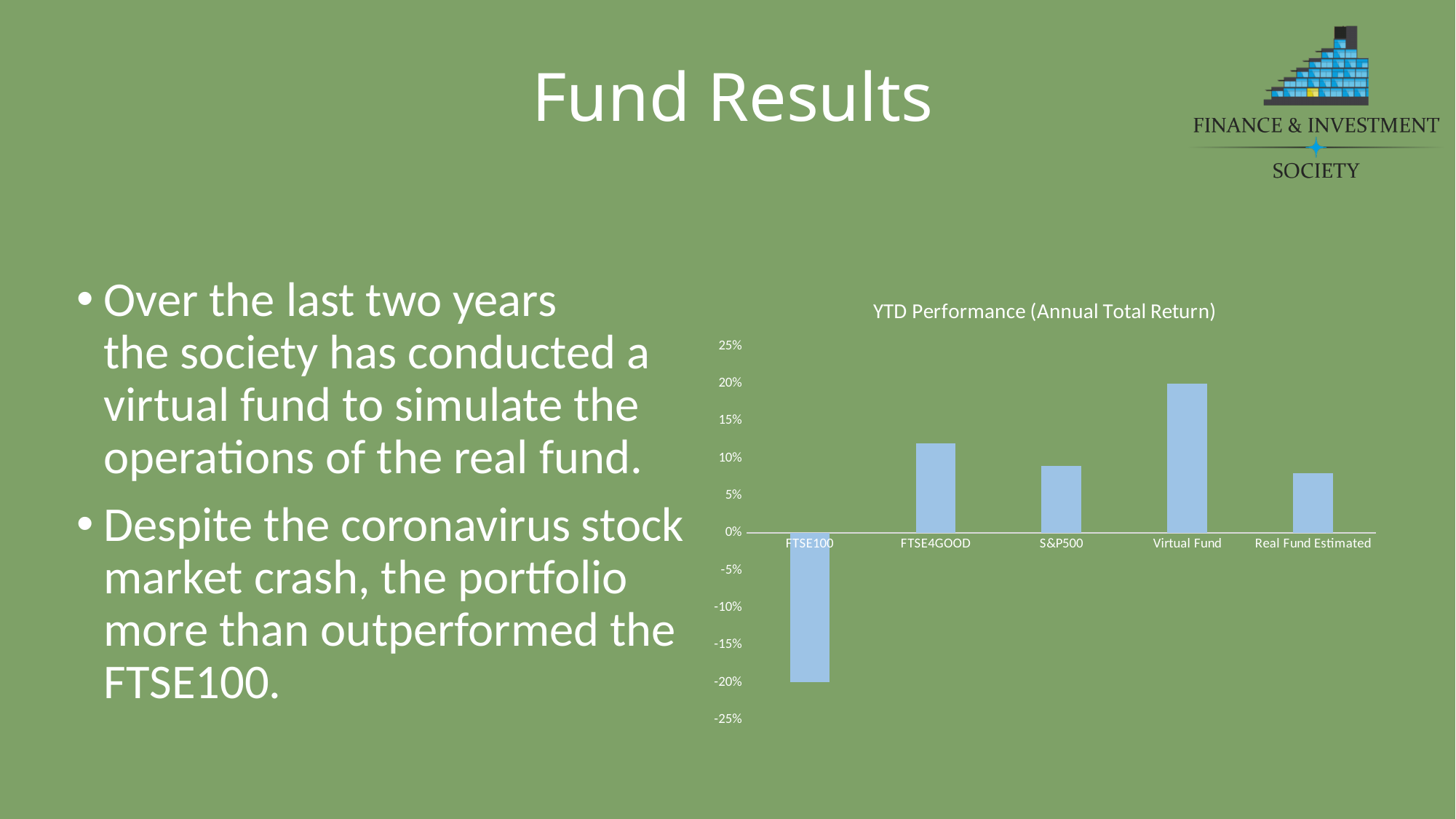
Is the value for S&P500 greater or less than 10%? less Which category has the highest YTD performance? Virtual Fund How many categories are plotted in the chart? 5 Is the value for FTSE4GOOD greater or less than 10%? greater How many categories in the chart have a negative value? 1 Which category has the lowest YTD performance? FTSE100 What is the title of the chart? YTD Performance (Annual Total Return) Which is larger, the value for FTSE4GOOD or the value for S&P500? FTSE4GOOD Is the value for Real Fund Estimated greater or less than 5%? greater Which is larger, the value for Virtual Fund or the value for Real Fund Estimated? Virtual Fund What kind of chart is shown on the slide? bar chart